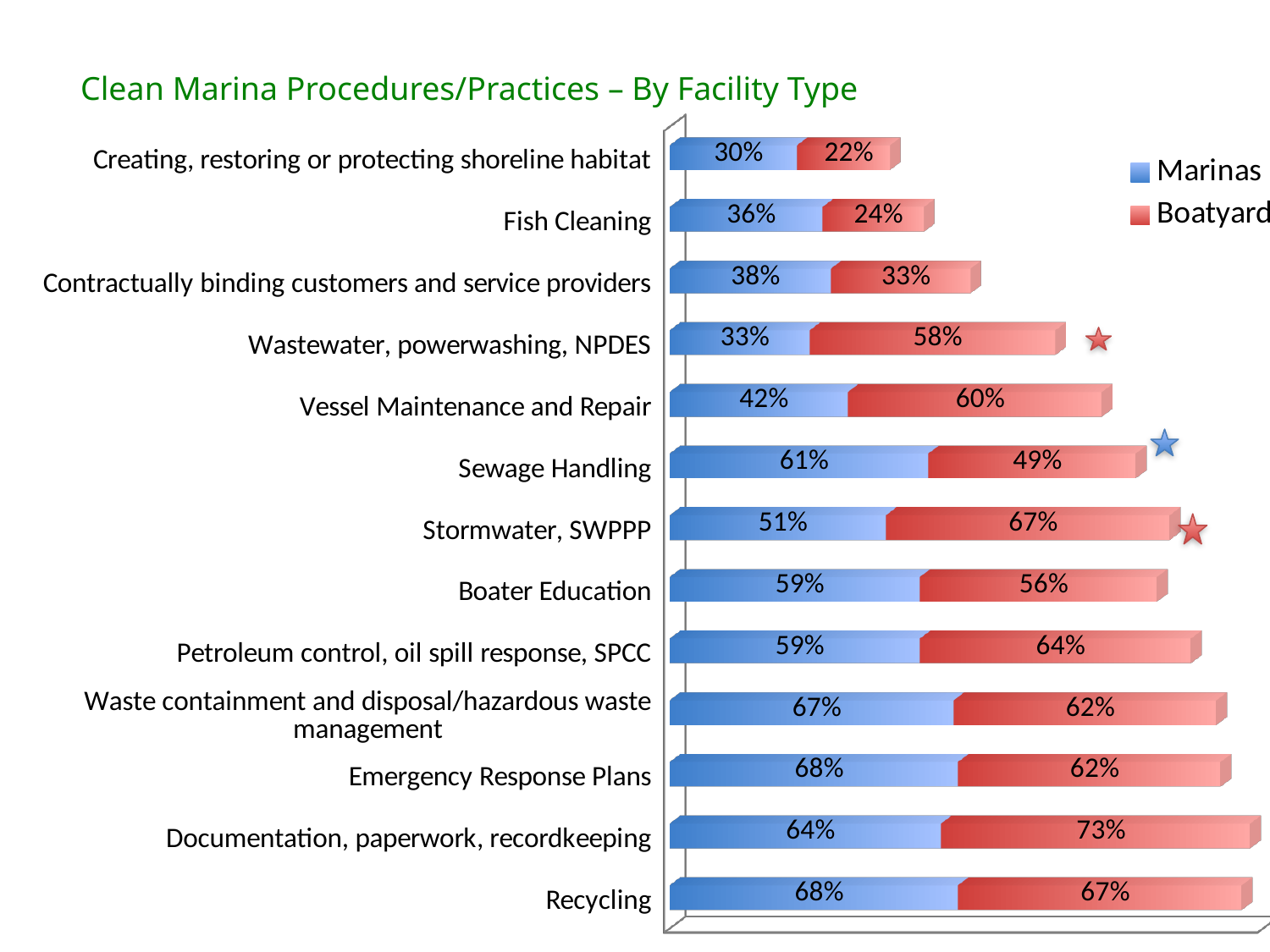
What is the title of the chart? Clean Marina Procedures/Practices – By Facility Type What is the Marinas value for Vessel Maintenance and Repair? 42% Which category has the highest Boatyard value? Documentation, paperwork, recordkeeping How many categories (procedures/practices) are plotted on the chart? 13 What is the total of the stacked bar for Recycling? 135% For Fish Cleaning, which is larger: the Marinas value or the Boatyard value? Marinas What kind of chart is shown on the slide? Bar chart What is the difference between the Boatyard and Marinas values for Stormwater, SWPPP? 16% Which category has the lowest Marinas value? Creating, restoring or protecting shoreline habitat What is the Boatyard value for Wastewater, powerwashing, NPDES? 58% How many series does the legend list? 2 What is the Marinas value for Sewage Handling? 61%